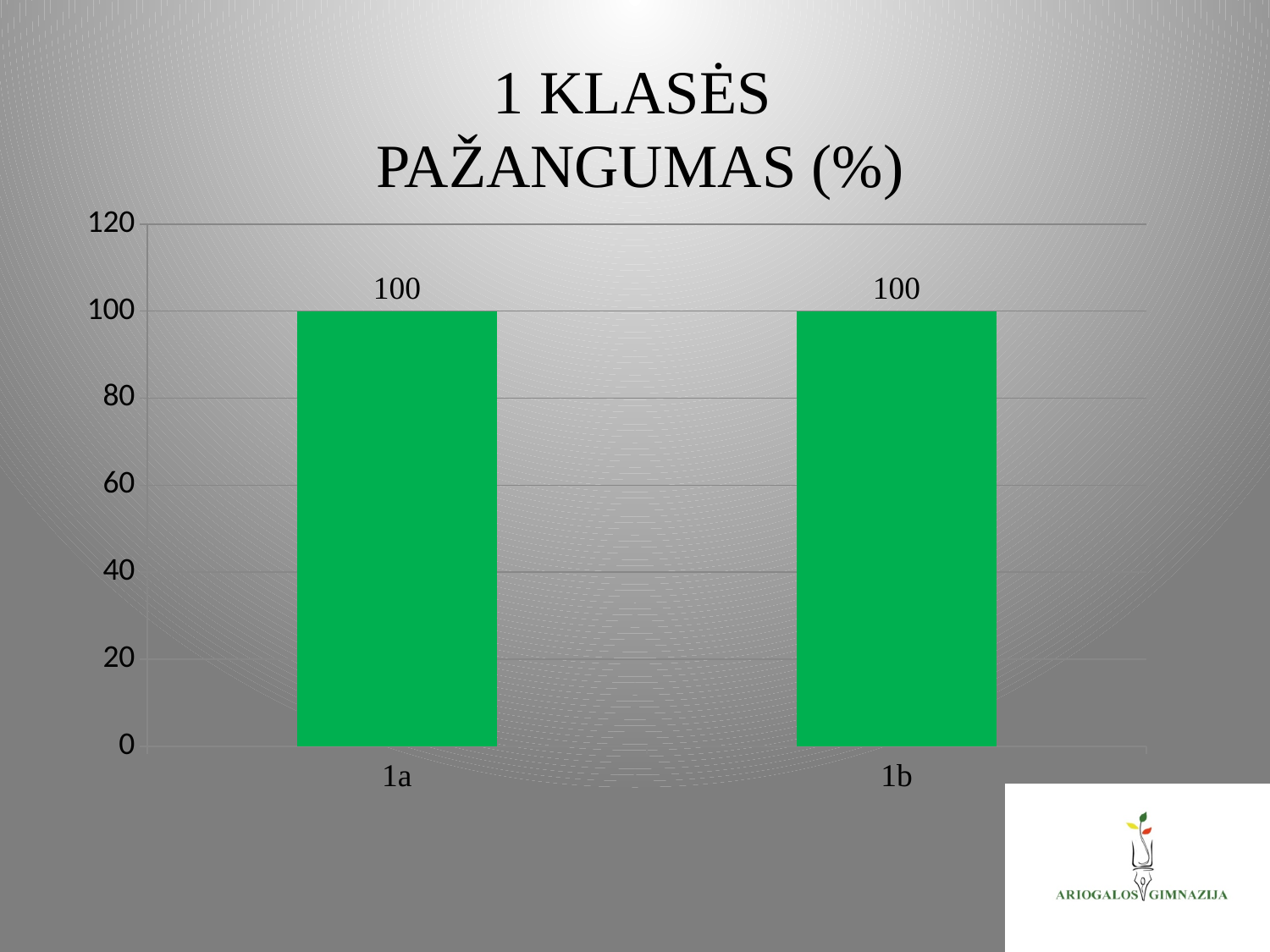
Do the values rise, fall or stay the same from 1a to 1b? stay the same Is the value for 1b greater or less than 120? less What is the value for 1b? 100 What kind of chart is shown on the slide? bar chart What is the difference between the values for 1a and 1b? 0 What is the highest value shown on the y axis? 120 What is the value for 1a? 100 How many categories are shown on the x axis? 2 What colour are the bars in the chart? green Is the value for 1a greater or less than 80? greater What is the title of the chart? 1 KLASĖS PAŽANGUMAS (%)